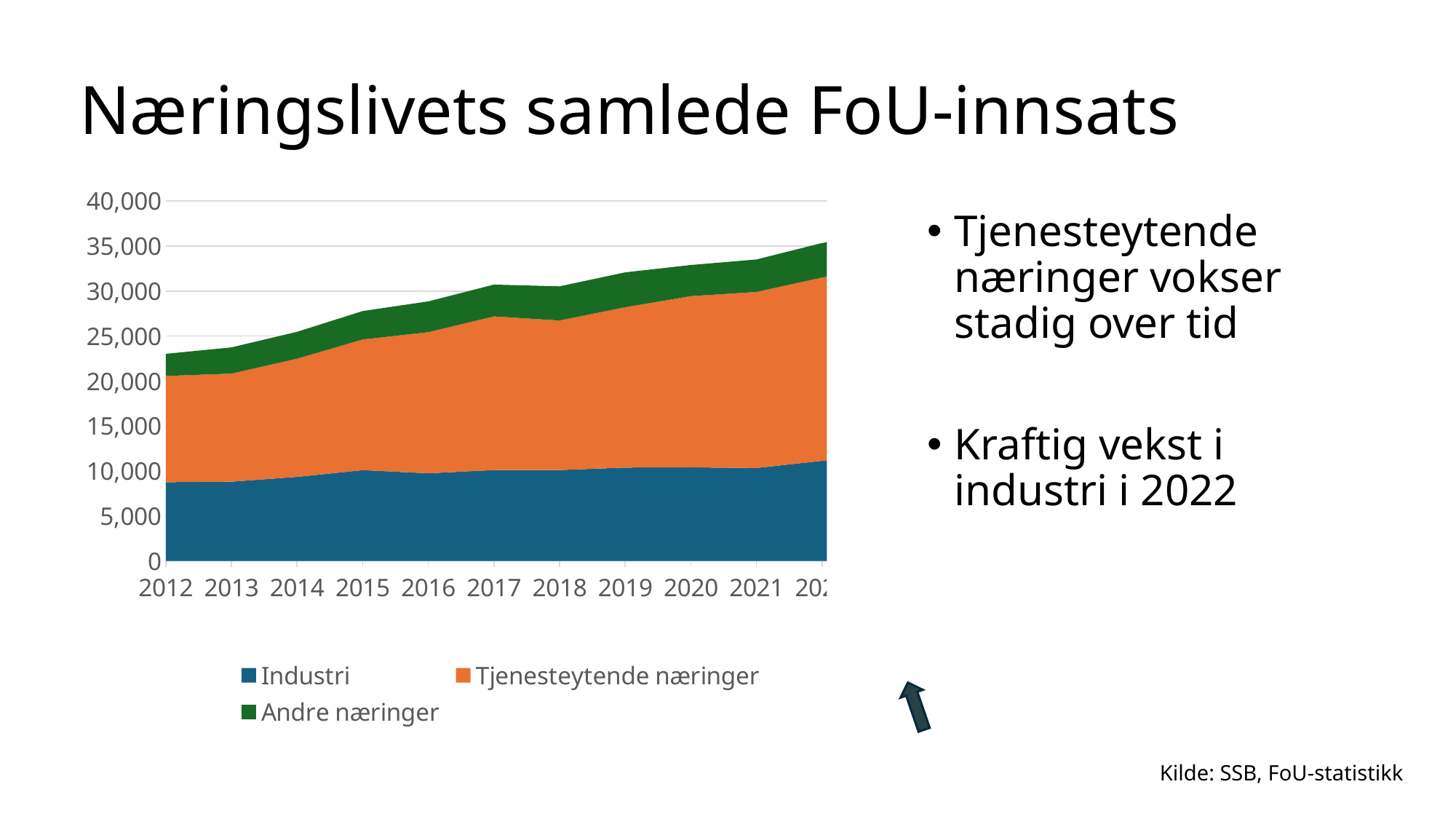
Which series is shown in green in the chart? Andre næringer Is the total of all three series in 2017 greater or less than 35,000? less Is the total of all three series in 2012 greater or less than 25,000? less What is the title of the chart on the slide? Næringslivets samlede FoU-innsats How many series does the legend list? 3 In 2012, which contributes more: Industri or Tjenesteytende næringer? Tjenesteytende næringer Which series contributes the smallest amount in 2012? Andre næringer Is the total of all three series in the last year shown greater or less than 30,000? greater Does the total FoU-innsats rise or fall from 2012 to the last year shown? rises What is the first year shown on the x axis? 2012 What kind of chart is shown on the slide? Stacked area chart